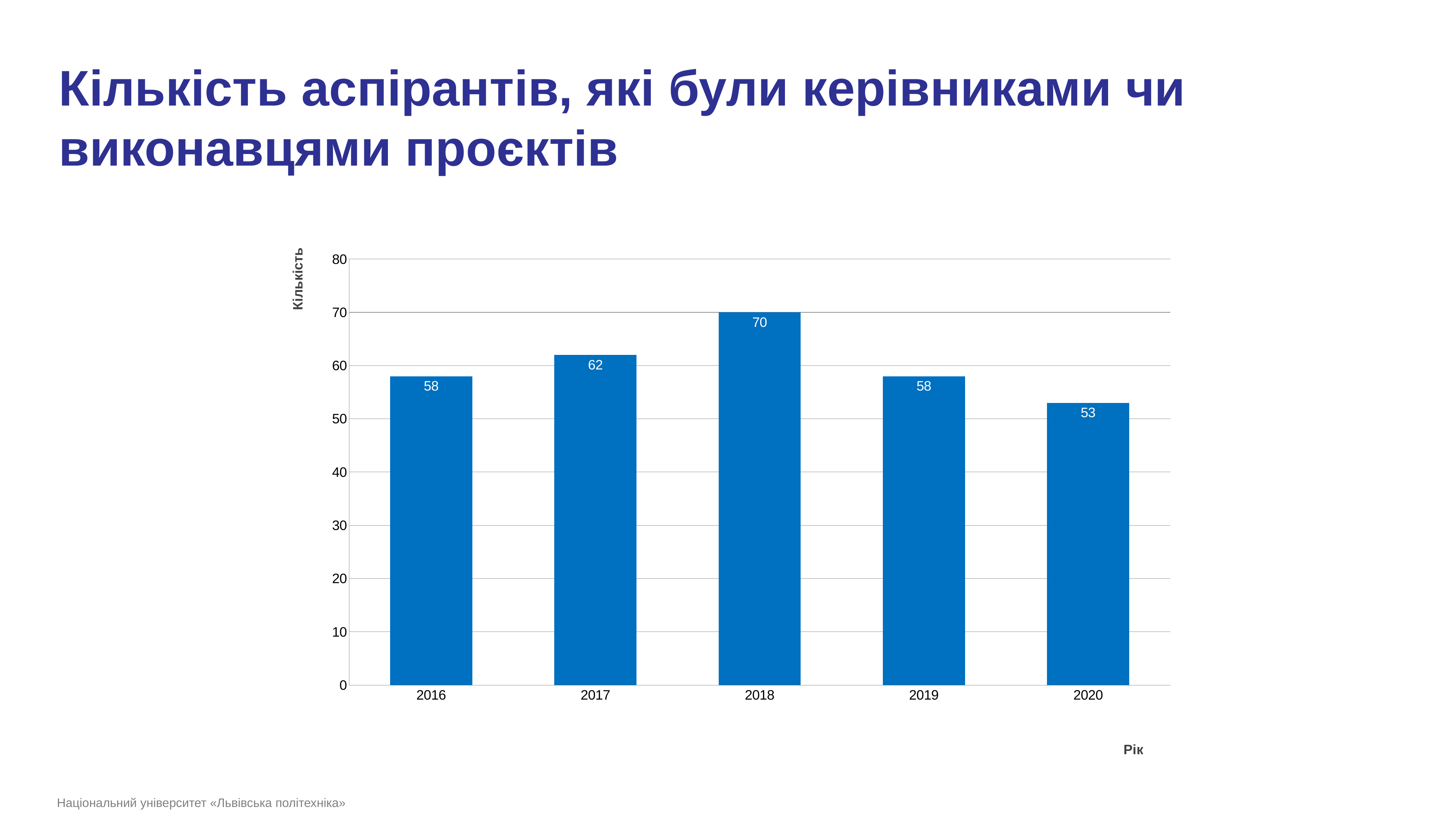
Which is larger, the value for 2017 or the value for 2019? 2017 What is the label of the x axis? Рік What is the difference between the values for 2017 and 2016? 4 Which year has the highest value? 2018 How many years are shown on the x axis? 5 What kind of chart is shown on the slide? bar chart Which year has the lowest value? 2020 What is the difference between the values for 2018 and 2020? 17 What is the value for 2018? 70 What is the value for 2017? 62 What is the value for 2020? 53 Is the value for 2020 greater or less than 60? less